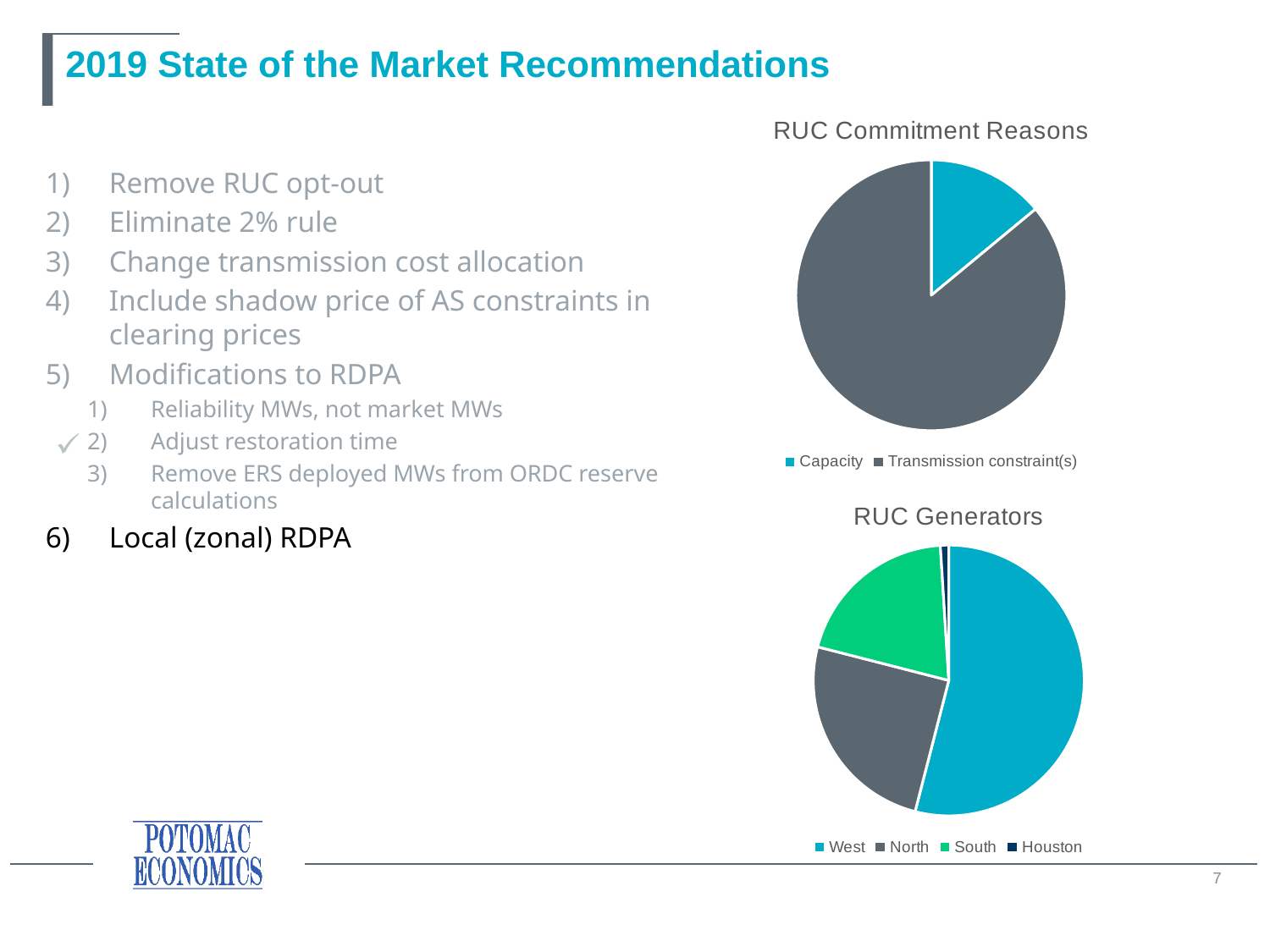
In the "RUC Commitment Reasons" chart, which category has the smallest slice? Capacity In the "RUC Commitment Reasons" chart, which category has the largest slice? Transmission constraint(s) What is the title of the upper pie chart on the slide? RUC Commitment Reasons How many zones does the legend of the "RUC Generators" chart list? 4 In the "RUC Generators" chart, which slice is larger, North or South? North How many categories does the legend of the "RUC Commitment Reasons" chart list? 2 In the "RUC Generators" chart, which zone has the smallest slice? Houston In the "RUC Generators" chart, what colour is the South slice? green In the "RUC Generators" chart, which zone has the largest slice? West In the "RUC Generators" chart, which slice is larger, West or North? West What kind of chart is the "RUC Commitment Reasons" chart? pie chart What kind of chart is the "RUC Generators" chart? pie chart